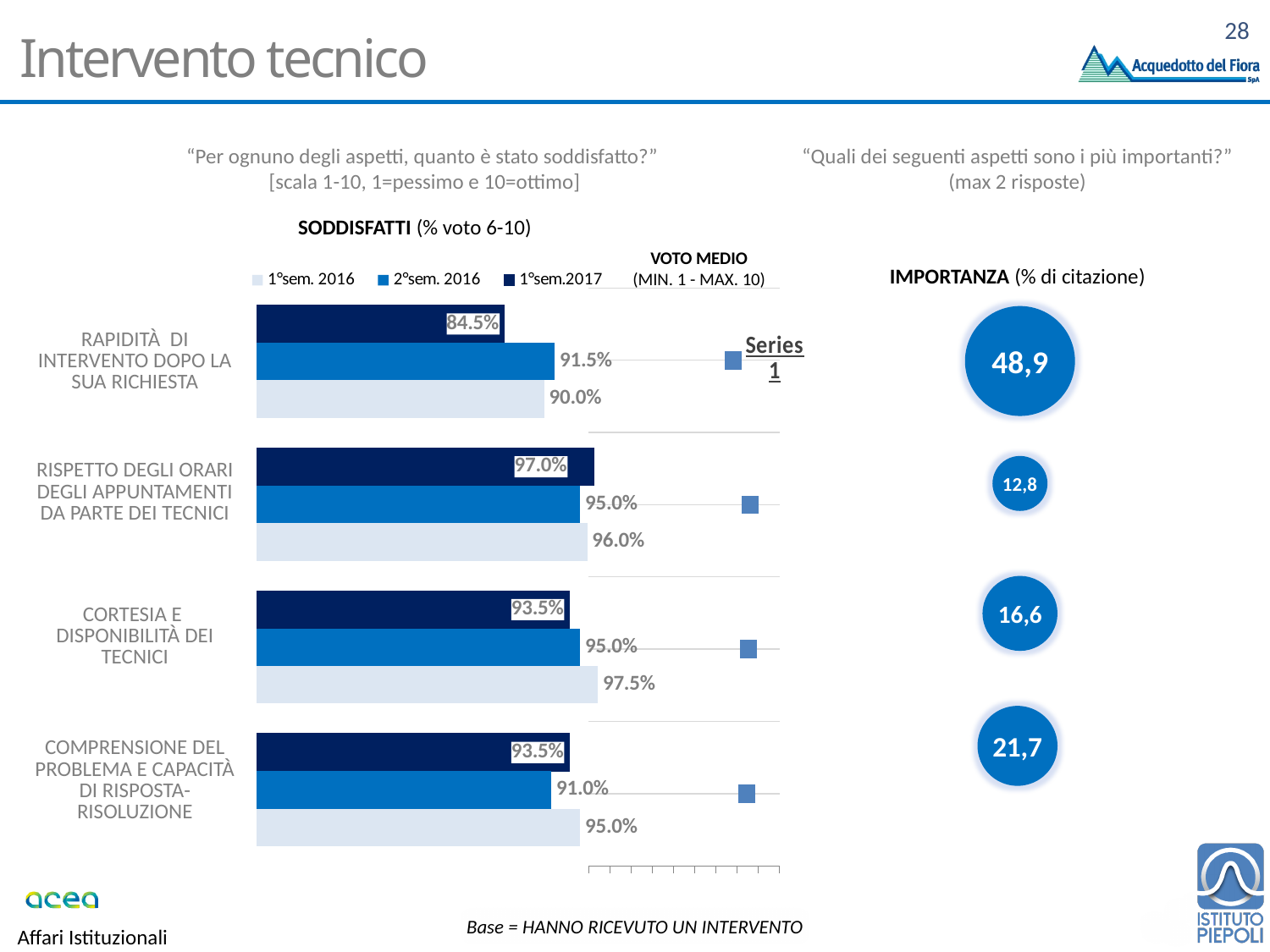
In the SODDISFATTI chart, what is the 1°sem.2017 value for RAPIDITÀ DI INTERVENTO DOPO LA SUA RICHIESTA? 84.5% In the SODDISFATTI chart, what is the difference between the 2°sem. 2016 and 1°sem.2017 values for RAPIDITÀ DI INTERVENTO DOPO LA SUA RICHIESTA? 7.0% In the IMPORTANZA (% di citazione) chart, which aspect has the lowest value? RISPETTO DEGLI ORARI DEGLI APPUNTAMENTI DA PARTE DEI TECNICI In the SODDISFATTI chart, for CORTESIA E DISPONIBILITÀ DEI TECNICI, which is larger: the 1°sem. 2016 value or the 1°sem.2017 value? 1°sem. 2016 In the SODDISFATTI chart, which category has the highest 1°sem.2017 value? RISPETTO DEGLI ORARI DEGLI APPUNTAMENTI DA PARTE DEI TECNICI How many series does the legend of the SODDISFATTI chart list? 3 In the IMPORTANZA (% di citazione) chart, what is the value for RAPIDITÀ DI INTERVENTO DOPO LA SUA RICHIESTA? 48,9 How many categories are shown in the SODDISFATTI chart? 4 In the SODDISFATTI chart, what is the 2°sem. 2016 value for COMPRENSIONE DEL PROBLEMA E CAPACITÀ DI RISPOSTA-RISOLUZIONE? 91.0% What kind of chart is the SODDISFATTI chart? Bar chart In the SODDISFATTI chart, which category has the lowest 1°sem.2017 value? RAPIDITÀ DI INTERVENTO DOPO LA SUA RICHIESTA In the SODDISFATTI chart, what is the 1°sem. 2016 value for CORTESIA E DISPONIBILITÀ DEI TECNICI? 97.5%